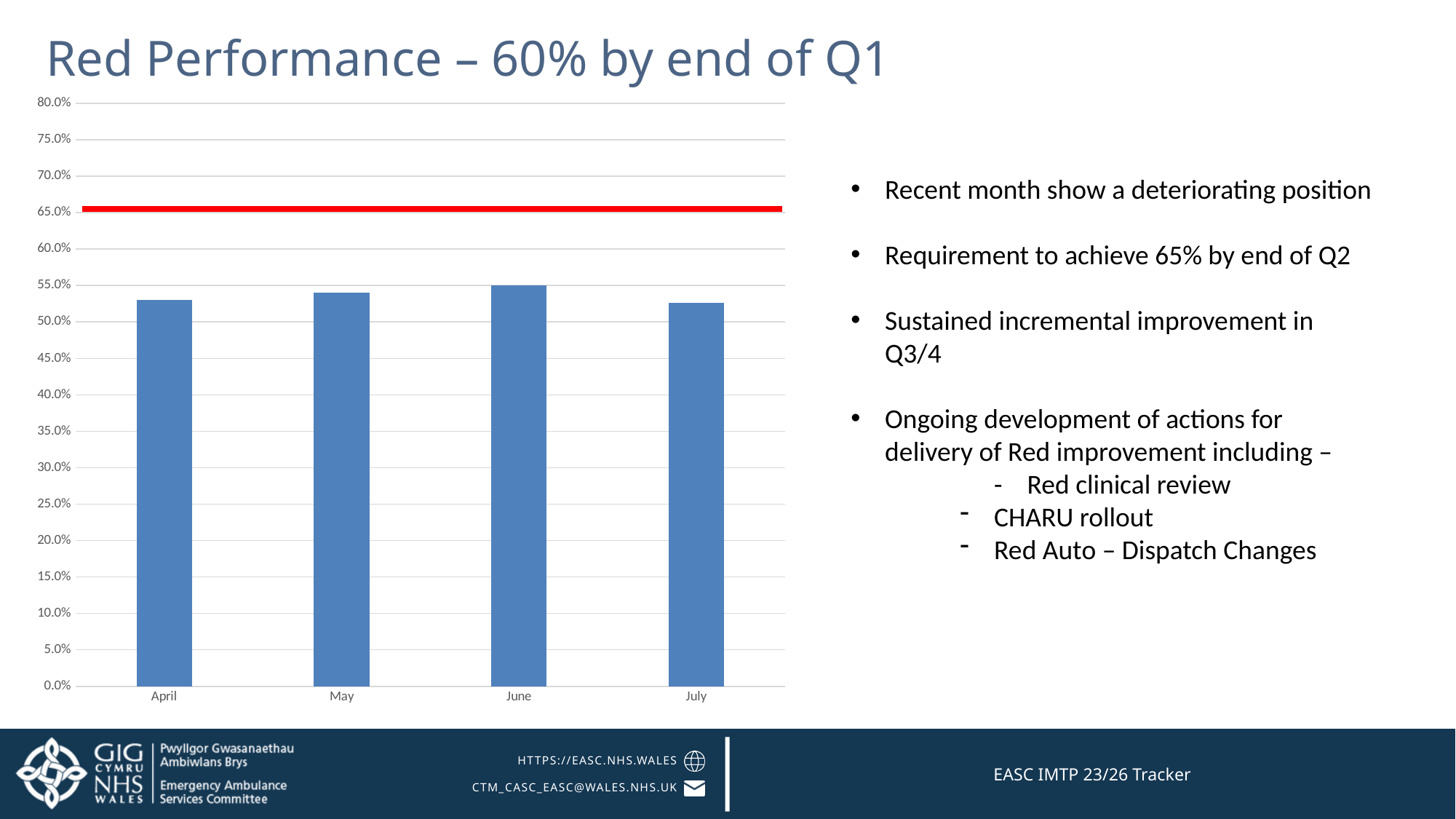
Which is larger, the value for April or the value for June? June Is the value for April greater or less than 50%? greater Is the value for May greater or less than 60%? less What kind of chart is shown on the slide? bar chart Is the value for June greater or less than 60%? less Which month has the highest bar in the chart? June Does the value rise or fall from June to July? fall Which is larger, the value for June or the value for July? June What is the title of the slide containing the chart? Red Performance – 60% by end of Q1 How many months are shown on the x axis of the chart? 4 At what level on the y axis is the horizontal red line drawn? 65.0%